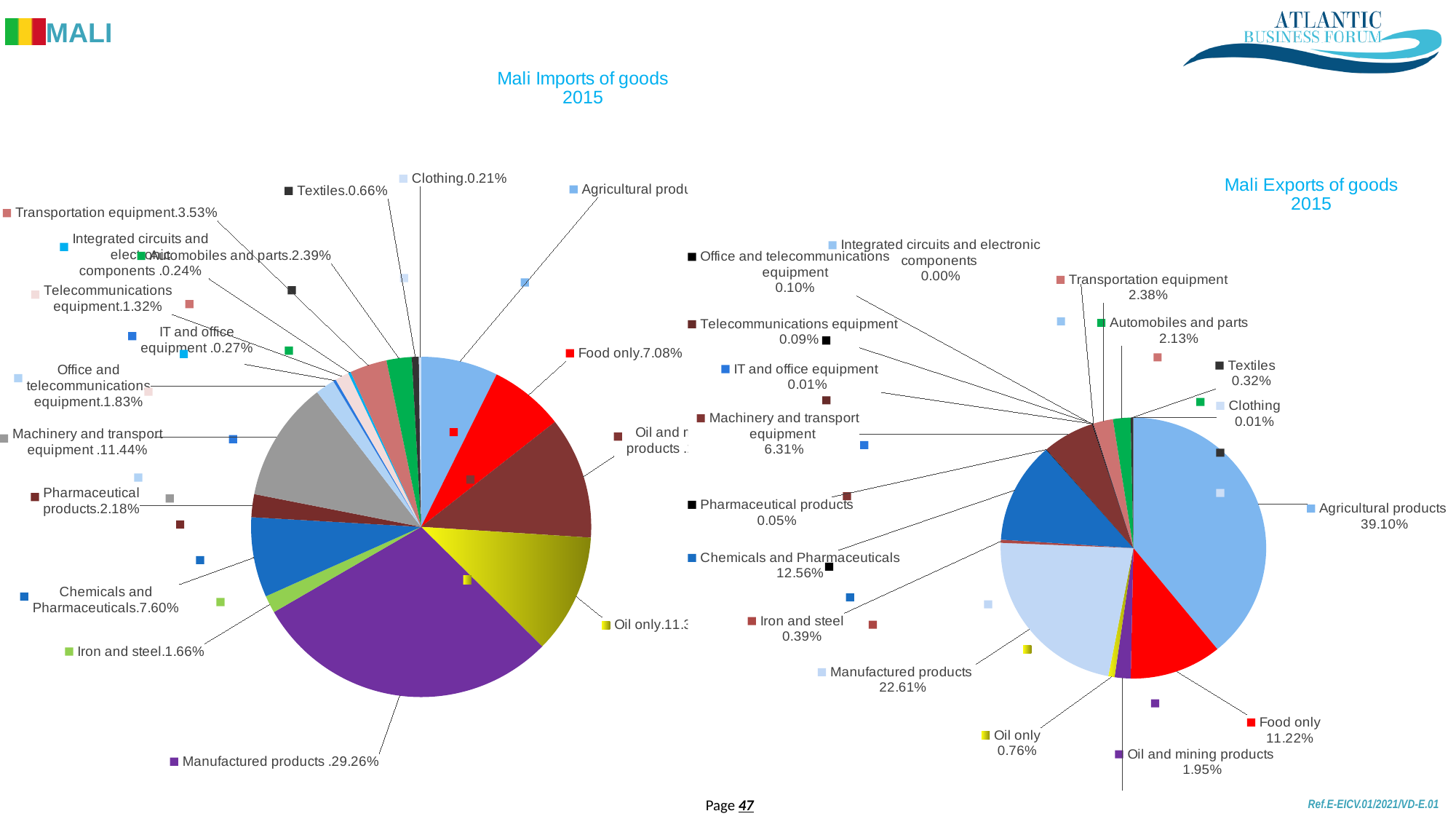
How many categories are shown in the Mali Exports of goods 2015 chart? 17 In the Mali Exports of goods 2015 chart, what is the share for Chemicals and Pharmaceuticals? 12.56% In the Mali Imports of goods 2015 chart, what is the share for Manufactured products? 29.26% In the Mali Exports of goods 2015 chart, which is larger: Machinery and transport equipment or Oil and mining products? Machinery and transport equipment In the Mali Exports of goods 2015 chart, which category has the largest share? Agricultural products In the Mali Imports of goods 2015 chart, which category has the largest share? Manufactured products In the Mali Imports of goods 2015 chart, what is the share for Machinery and transport equipment? 11.44% In the Mali Imports of goods 2015 chart, what is the difference between the shares of Chemicals and Pharmaceuticals and Food only? 0.52% In the Mali Exports of goods 2015 chart, what is the share for Agricultural products? 39.10% What type of chart is used for Mali Imports of goods 2015? Pie chart In the Mali Imports of goods 2015 chart, which is larger: Transportation equipment or Automobiles and parts? Transportation equipment In the Mali Exports of goods 2015 chart, what is the difference between the shares of Manufactured products and Food only? 11.39%